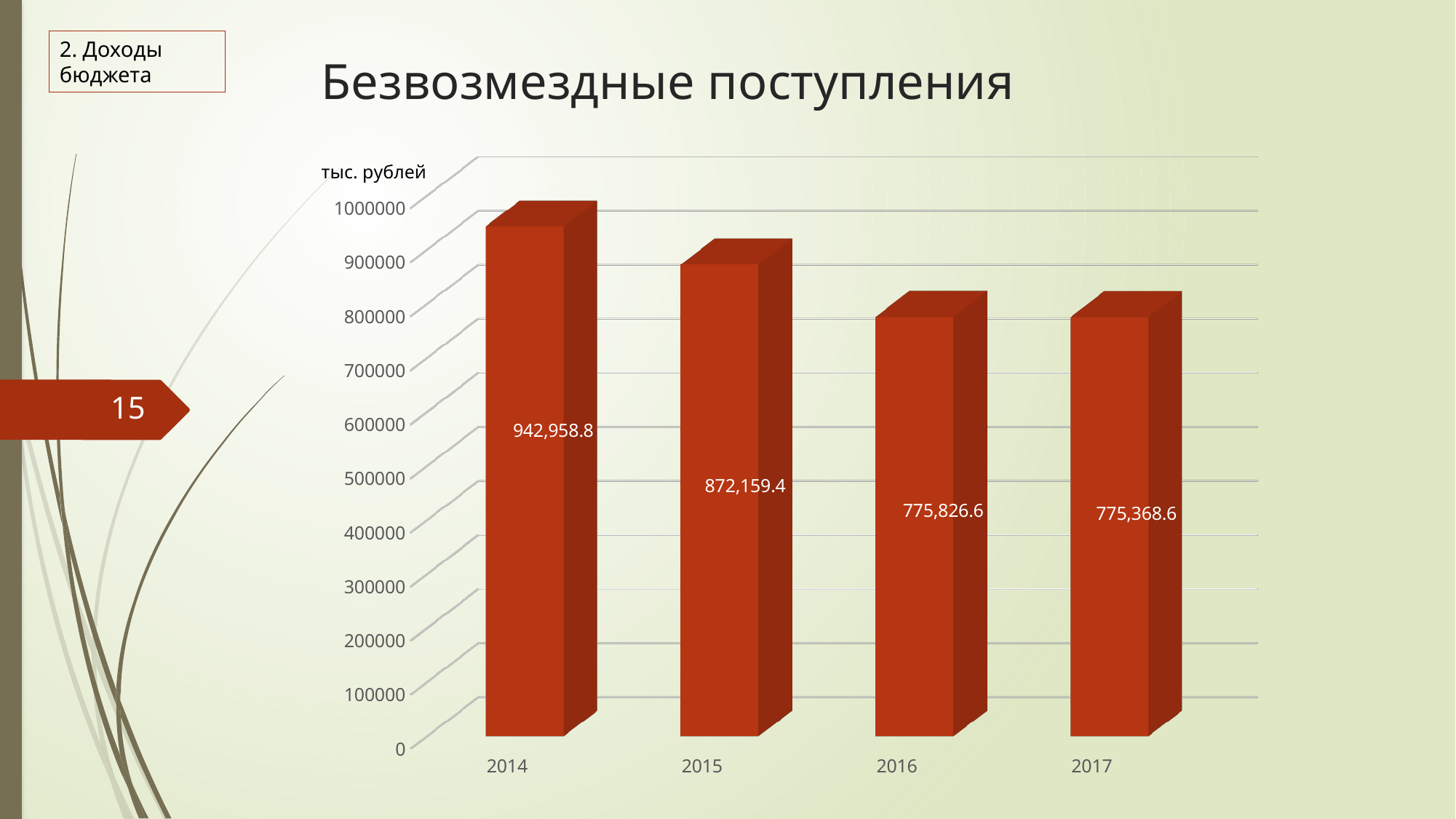
Is the value for 2016 greater or less than 800000? less What is the value for 2015? 872,159.4 What is the value for 2014? 942,958.8 What is the difference between the values for 2016 and 2017? 458.0 Which is larger, the value for 2015 or the value for 2016? 2015 Which year has the lowest value according to the data labels? 2017 What is the difference between the values for 2014 and 2015? 70,799.4 What is the value for 2017? 775,368.6 Which year has the highest value? 2014 What is the value for 2016? 775,826.6 Do the values rise or fall from 2014 to 2017? fall How many years are shown on the x axis? 4